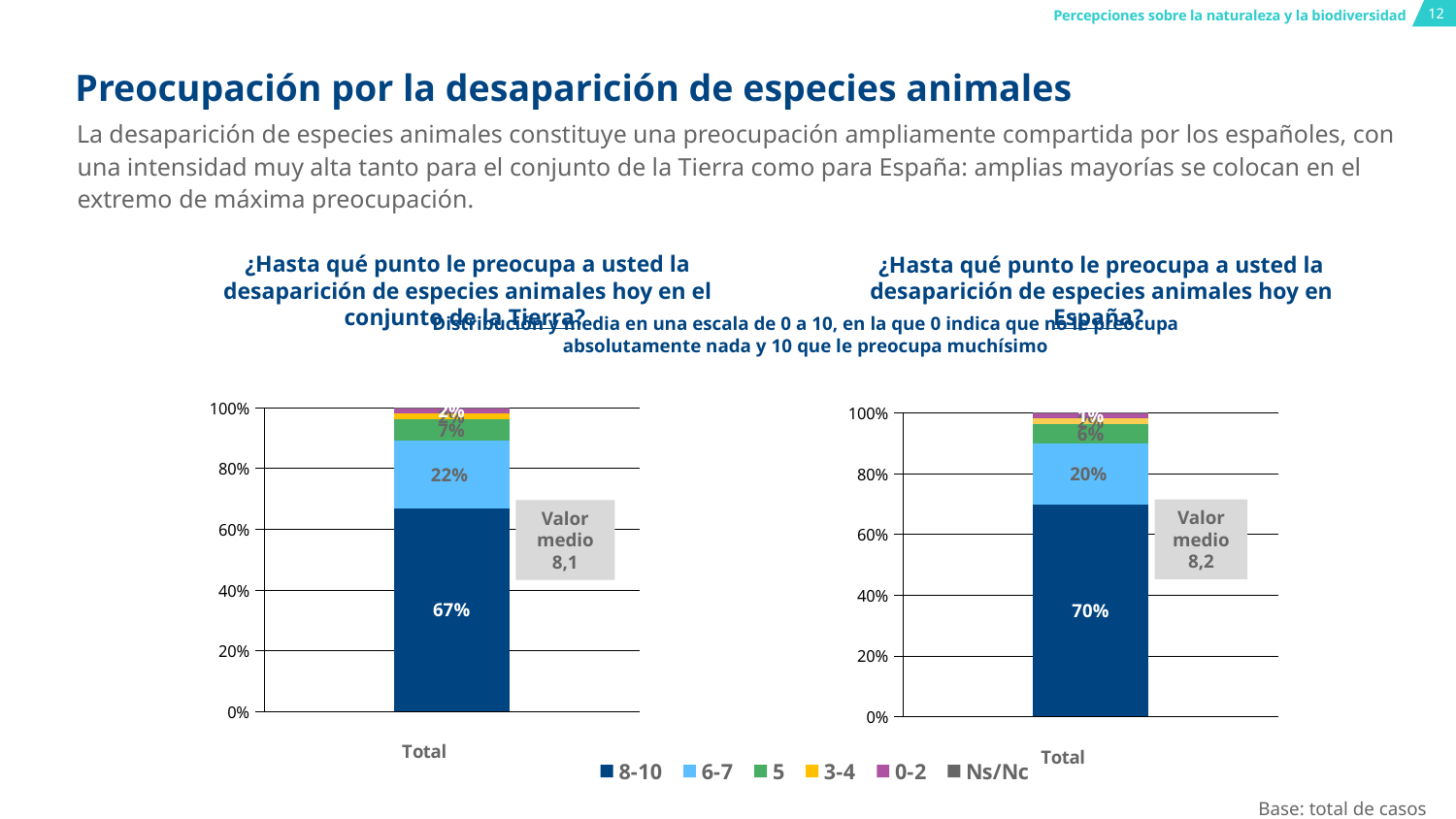
What is the 'Valor medio' shown for the right chart (España)? 8,2 How many series does the legend list for the charts? 6 In the left chart (conjunto de la Tierra), what percentage of respondents gave a score of 5? 7% In the right chart (España), what percentage of respondents gave a score of 5? 6% What kind of chart is used on this slide? Stacked bar chart In the right chart (España), what percentage of respondents gave a score of 6-7? 20% What is the difference between the 8-10 share in the right chart (España) and the 8-10 share in the left chart (conjunto de la Tierra)? 3 percentage points In the right chart (España), what percentage of respondents gave a score of 8-10? 70% In the left chart (conjunto de la Tierra), what percentage of respondents gave a score of 6-7? 22% In the left chart (conjunto de la Tierra), what percentage of respondents gave a score of 8-10? 67% Which is larger: the 8-10 share in the left chart (conjunto de la Tierra) or the 8-10 share in the right chart (España)? España (70%) What is the 'Valor medio' shown for the left chart (conjunto de la Tierra)? 8,1